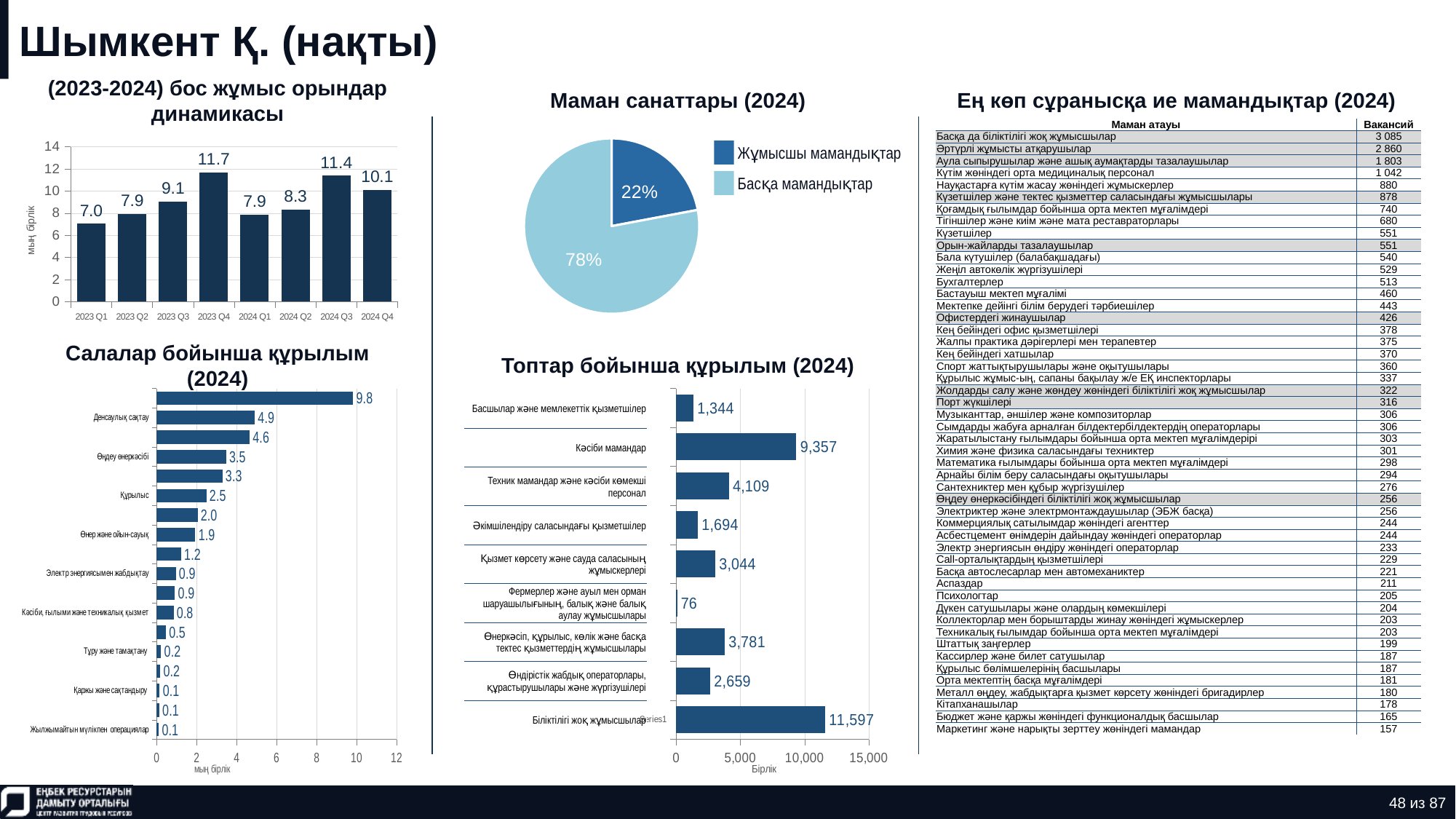
In the chart '(2023-2024) бос жұмыс орындар динамикасы', how many quarters are plotted? 8 In the chart 'Салалар бойынша құрылым (2024)', what is the highest value shown? 9.8 What kind of chart is 'Топтар бойынша құрылым (2024)'? bar chart In the chart '(2023-2024) бос жұмыс орындар динамикасы', which quarter has the lowest value? 2023 Q1 In the chart 'Топтар бойынша құрылым (2024)', which is larger: 'Техник мамандар және кәсіби көмекші персонал' or 'Өнеркәсіп, құрылыс, көлік және басқа тектес қызметтердің жұмысшылары'? Техник мамандар және кәсіби көмекші персонал In the chart 'Топтар бойынша құрылым (2024)', which category has the highest value? Біліктілігі жоқ жұмысшылар In the chart '(2023-2024) бос жұмыс орындар динамикасы', what is the value for 2023 Q4? 11.7 In the chart 'Топтар бойынша құрылым (2024)', what is the value for 'Кәсіби мамандар'? 9,357 In the chart '(2023-2024) бос жұмыс орындар динамикасы', what is the difference between 2024 Q3 and 2024 Q4? 1.3 In the chart '(2023-2024) бос жұмыс орындар динамикасы', is the value for 2024 Q1 greater or less than 8? less In the pie chart 'Маман санаттары (2024)', what share is 'Жұмысшы мамандықтар'? 22% How many entries does the legend of the pie chart 'Маман санаттары (2024)' list? 2